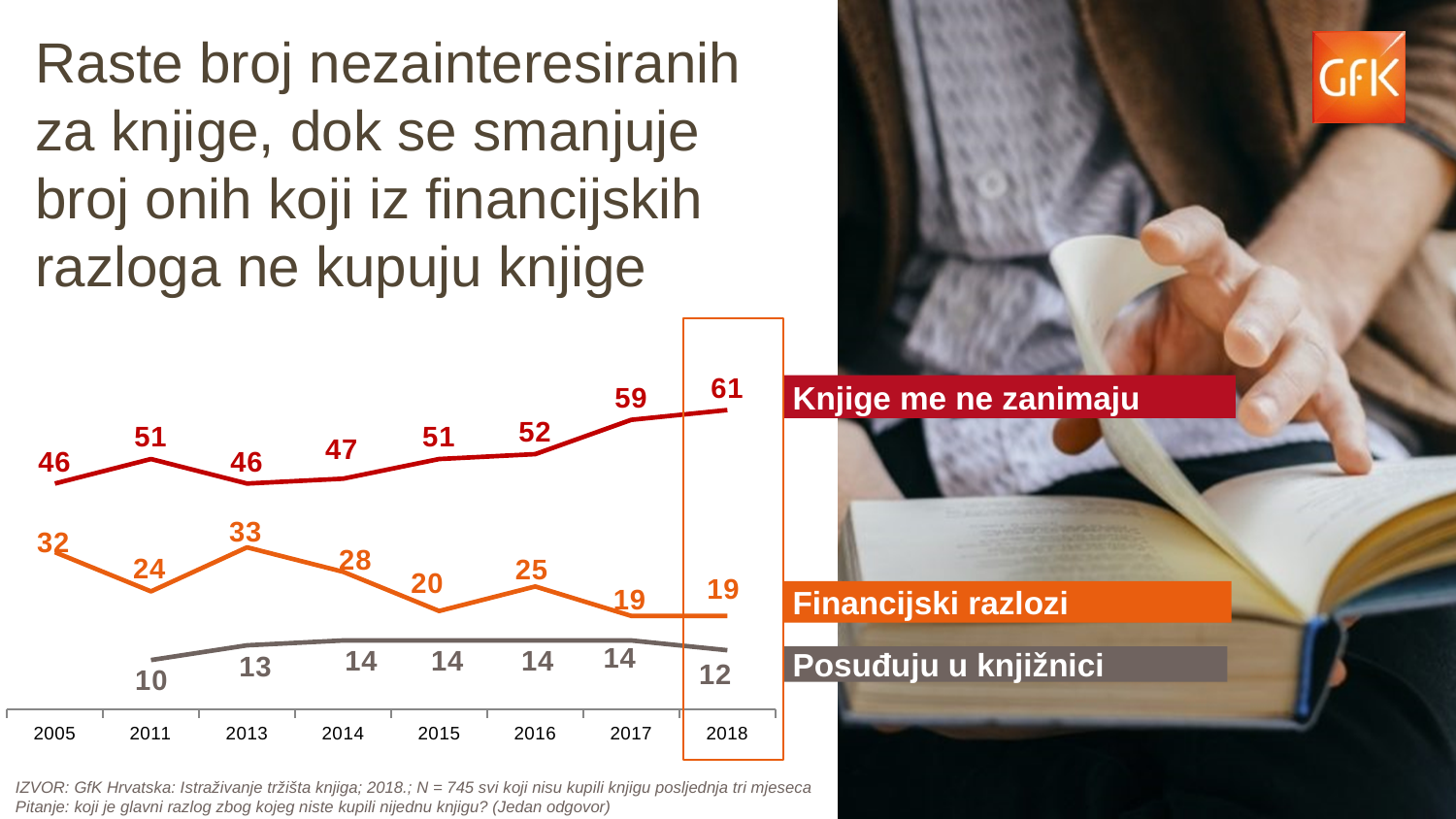
How many series does the chart show? 3 Which series is drawn in orange? Financijski razlozi In which year is the value for "Knjige me ne zanimaju" highest? 2018 How many years are shown on the x axis of the chart? 8 What is the value for "Posuđuju u knjižnici" in 2011? 10 What kind of chart is shown on the slide? Line chart What is the value for "Financijski razlozi" in 2005? 32 In which year is the value for "Financijski razlozi" lowest? 2017 and 2018 Which is larger in 2013: the value for "Financijski razlozi" or the value for "Posuđuju u knjižnici"? Financijski razlozi What is the value for "Knjige me ne zanimaju" in 2018? 61 Does the value for "Knjige me ne zanimaju" rise or fall from 2016 to 2018? Rise What is the difference between the "Knjige me ne zanimaju" values in 2018 and 2005? 15